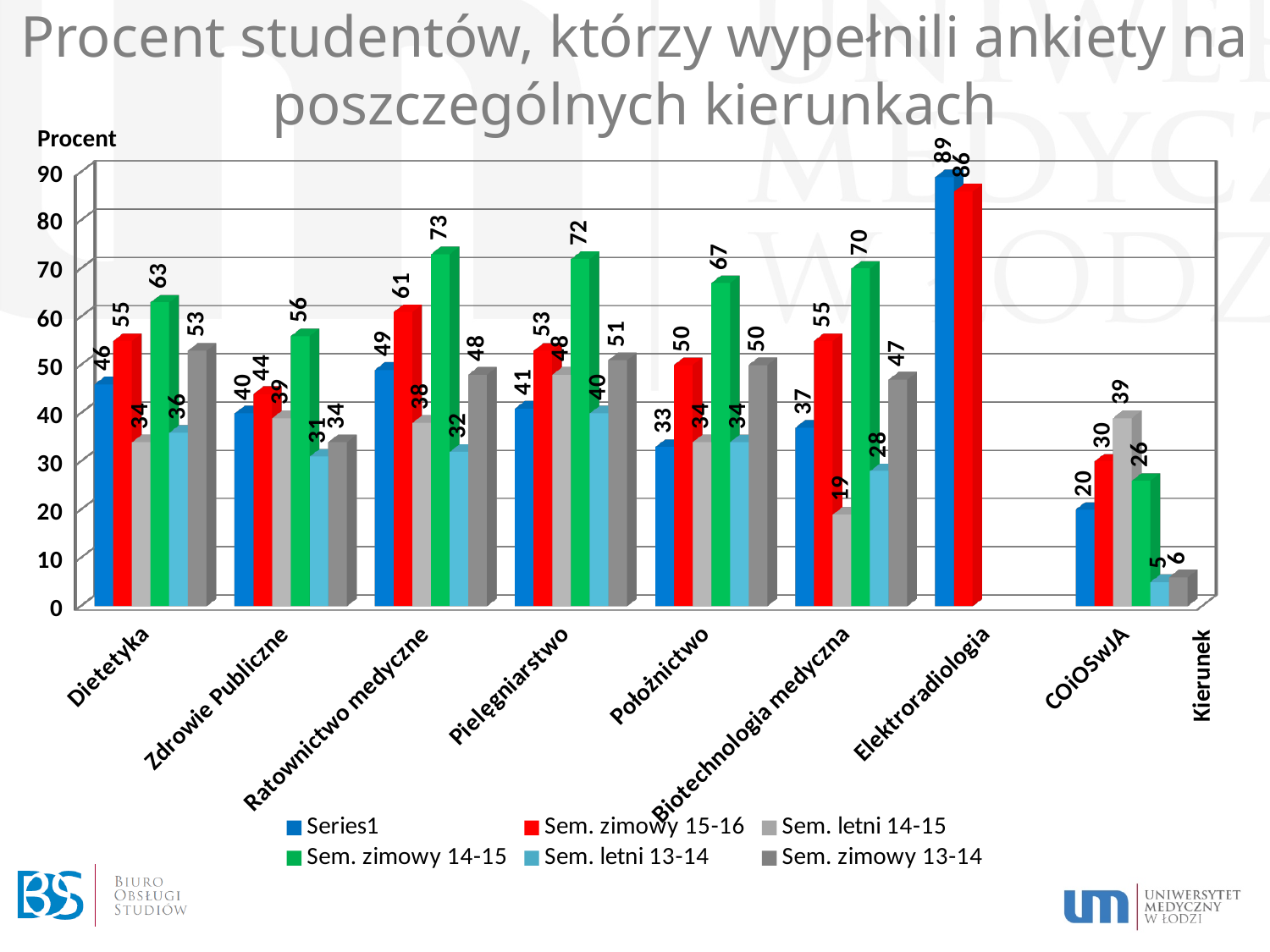
What is the Series1 value for Elektroradiologia? 89 What is the value for Sem. letni 14-15 for COiOSwJA? 39 What is the value for Sem. zimowy 14-15 for Ratownictwo medyczne? 73 What kind of chart is shown on the slide? bar chart What is the label of the vertical axis? Procent Which category has the lowest value for Sem. letni 13-14? COiOSwJA How many series does the legend list? 6 For Biotechnologia medyczna, which is larger: Sem. zimowy 15-16 or Sem. letni 14-15? Sem. zimowy 15-16 For Dietetyka, what is the difference between the Sem. zimowy 14-15 value and the Series1 value? 17 What is the value for Sem. zimowy 13-14 for Położnictwo? 50 Which category has the highest Series1 value? Elektroradiologia How many categories (kierunki) are shown on the x axis? 8